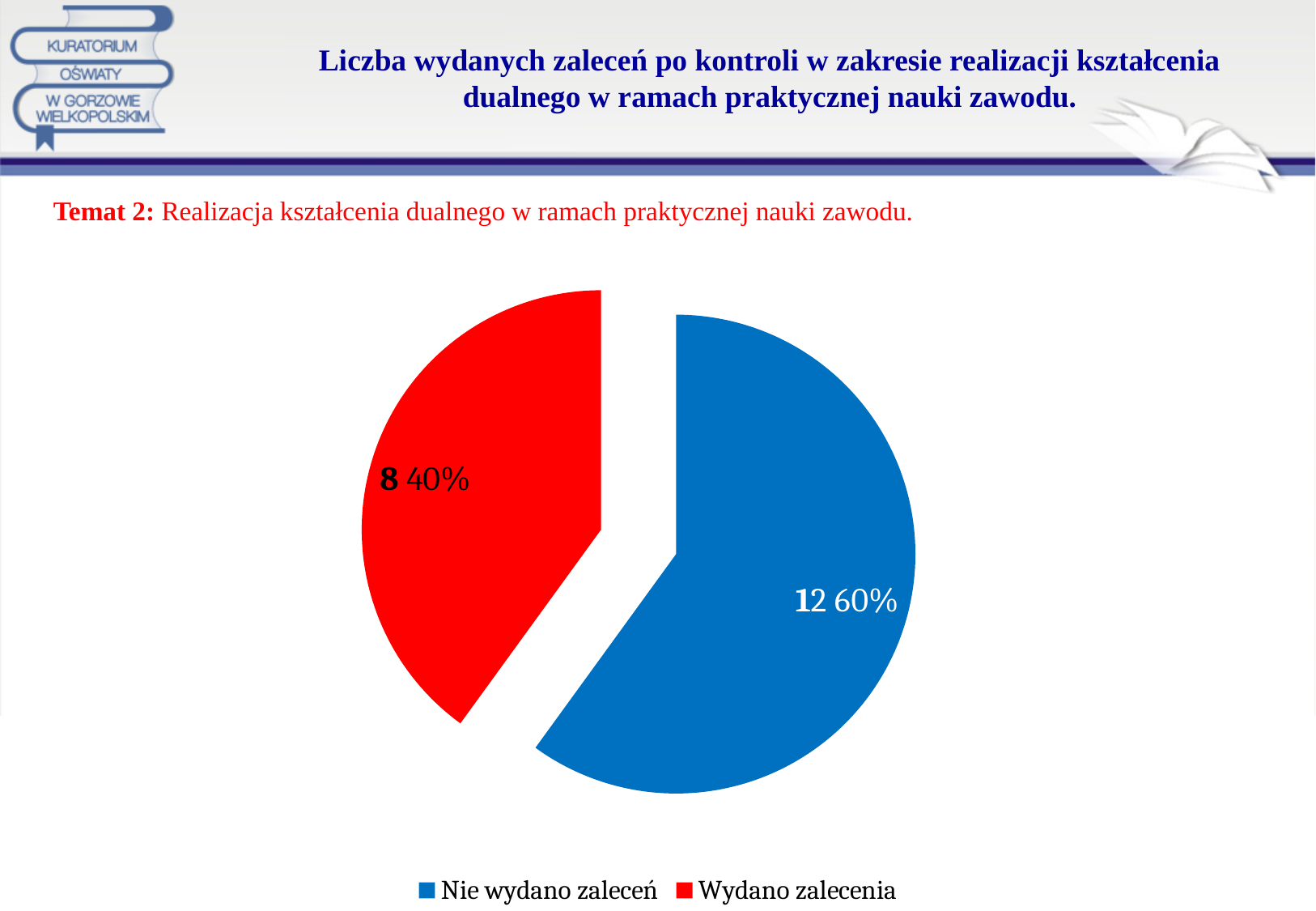
How many slices does the pie chart have? 2 What share of the pie does "Wydano zalecenia" represent? 40% What is the value for "Nie wydano zaleceń"? 12 What colour is the slice for "Wydano zalecenia"? red What kind of chart is shown on the slide? pie chart Which category has the largest slice? Nie wydano zaleceń Which category has the smallest slice? Wydano zalecenia What is the difference between the values for "Nie wydano zaleceń" and "Wydano zalecenia"? 4 Which is larger, the value for "Nie wydano zaleceń" or "Wydano zalecenia"? Nie wydano zaleceń What is the value for "Wydano zalecenia"? 8 How many entries does the legend list? 2 What share of the pie does "Nie wydano zaleceń" represent? 60%